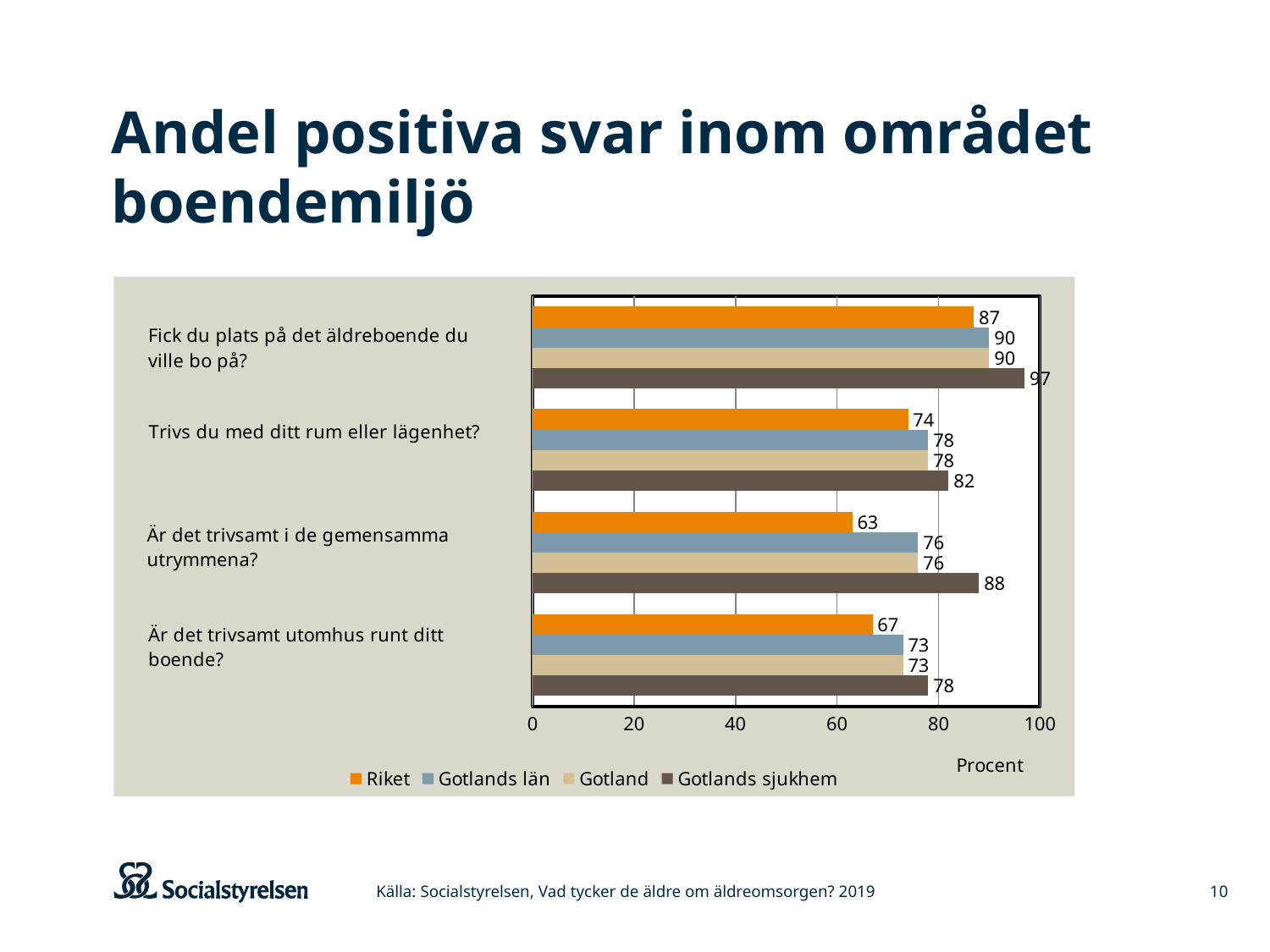
Which series is shown in orange in the legend? Riket What is the unit shown on the x axis of the chart? Procent How many series does the legend list? 4 How many questions (categories) are shown on the chart? 4 What is the difference between Gotlands sjukhem and Riket for "Är det trivsamt i de gemensamma utrymmena?"? 25 What kind of chart is shown on the slide? Bar chart Which series has the highest value for "Trivs du med ditt rum eller lägenhet?"? Gotlands sjukhem What is the value for Gotlands län for "Är det trivsamt utomhus runt ditt boende?"? 73 What is the value for Riket for "Är det trivsamt i de gemensamma utrymmena?"? 63 What is the value for Gotlands sjukhem for "Fick du plats på det äldreboende du ville bo på?"? 97 Which is larger for "Trivs du med ditt rum eller lägenhet?": Riket or Gotland? Gotland Which question has the lowest value for Riket? Är det trivsamt i de gemensamma utrymmena?